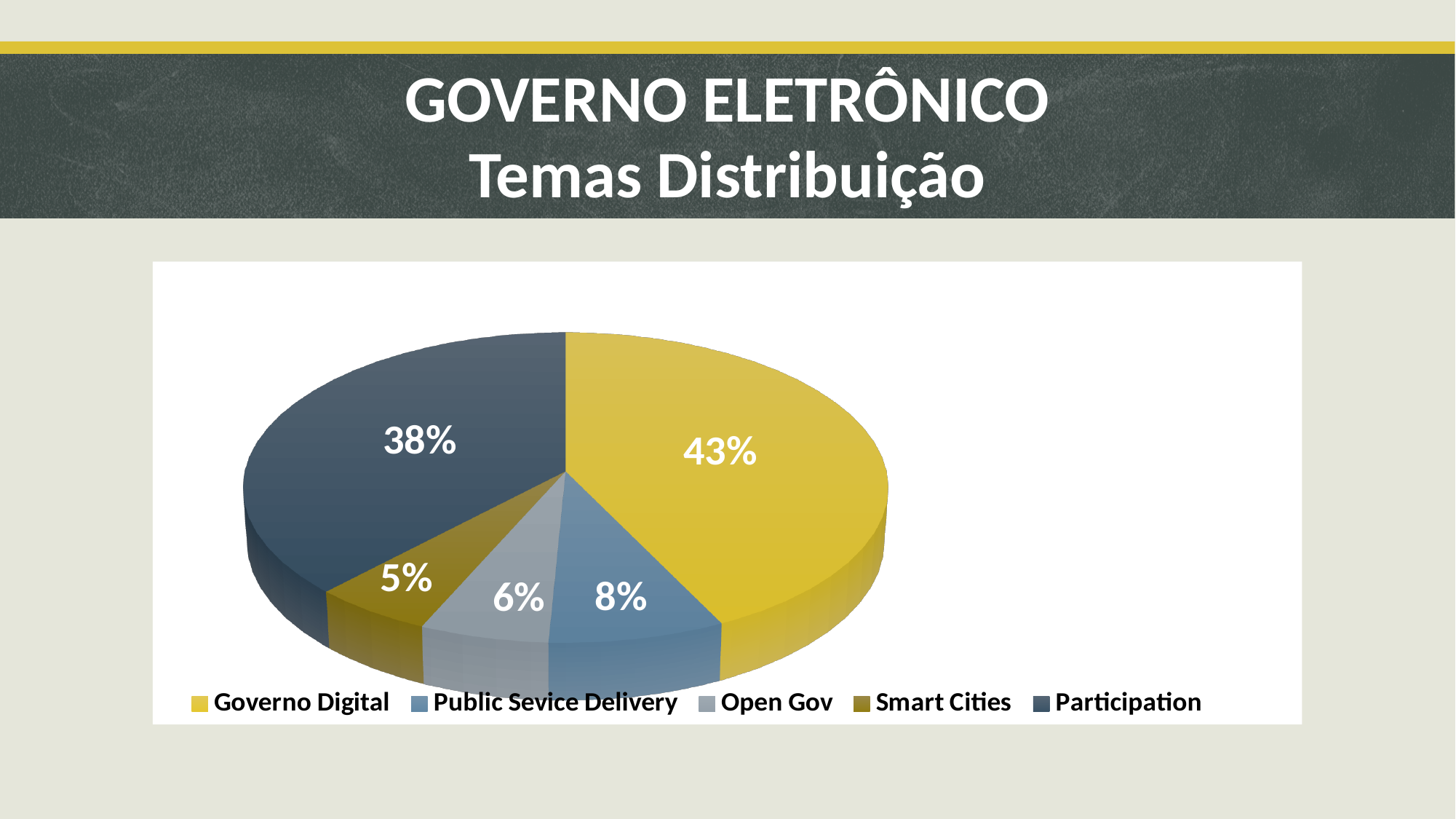
What kind of chart is shown on the slide? pie chart What is the difference in percentage points between Governo Digital and Participation? 5 What share of the pie does Participation have? 38% Which category has the largest slice of the pie? Governo Digital What share of the pie does Public Sevice Delivery have? 8% How many categories does the legend list? 5 Which category has the smallest slice of the pie? Smart Cities What share of the pie does Smart Cities have? 5% Which legend entry is shown in yellow? Governo Digital Which is larger, the share for Public Sevice Delivery or the share for Open Gov? Public Sevice Delivery